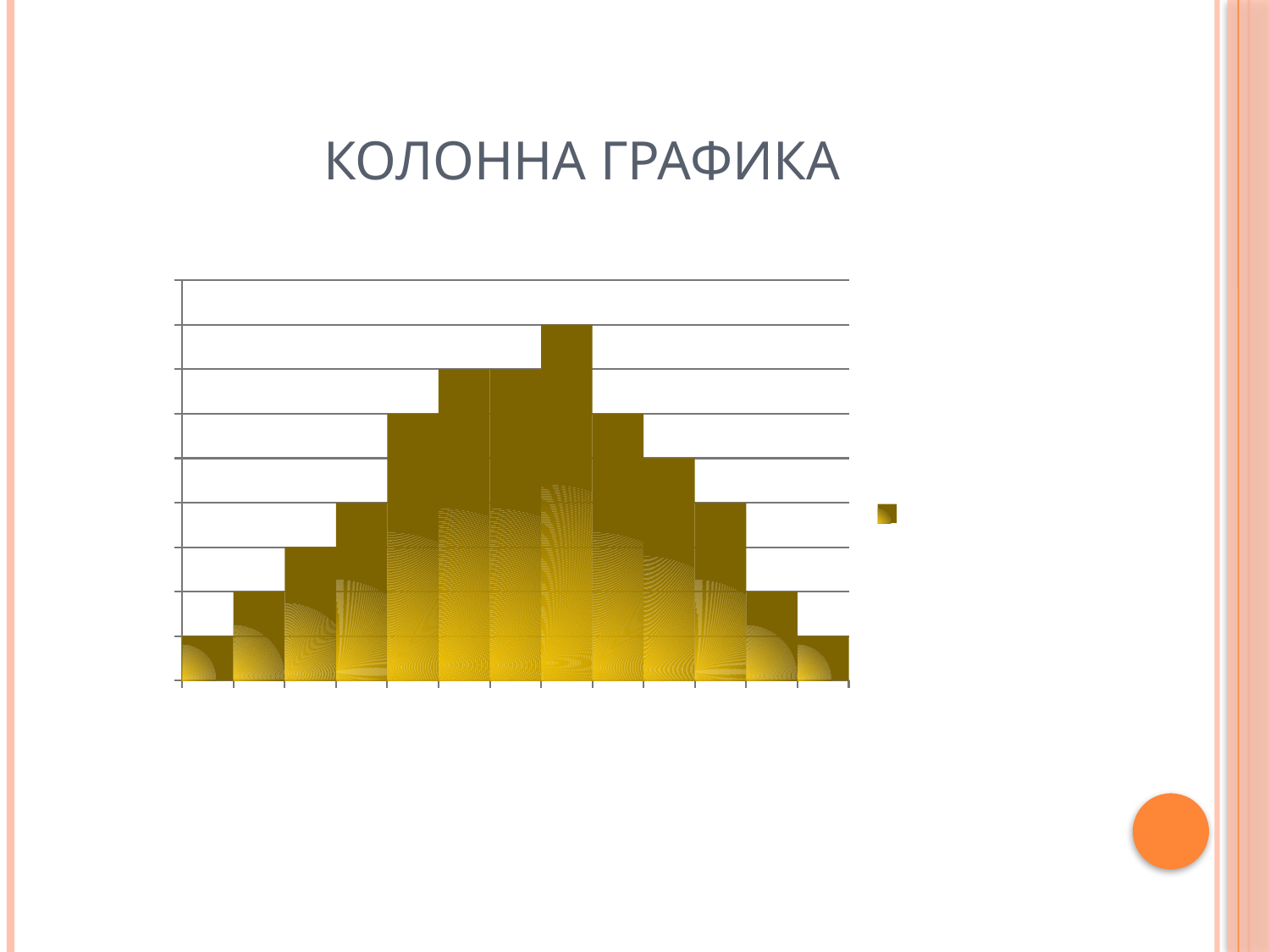
What is the title of the slide containing the chart? КОЛОННА ГРАФИКА How many bars does the chart contain? 13 What kind of chart is shown on the slide? bar chart What colour are the bars in the chart? gold (yellow-brown) Do the bar heights rise or fall from the first bar to the eighth bar? rise Do the bar heights rise or fall from the eighth bar to the last bar? fall How many series does the legend list? 1 Which is taller, the third bar from the left or the fifth bar from the left? the fifth bar Which is taller, the sixth bar from the left or the tenth bar from the left? the sixth bar Which bar is the tallest in the chart, counting from the left? the eighth bar